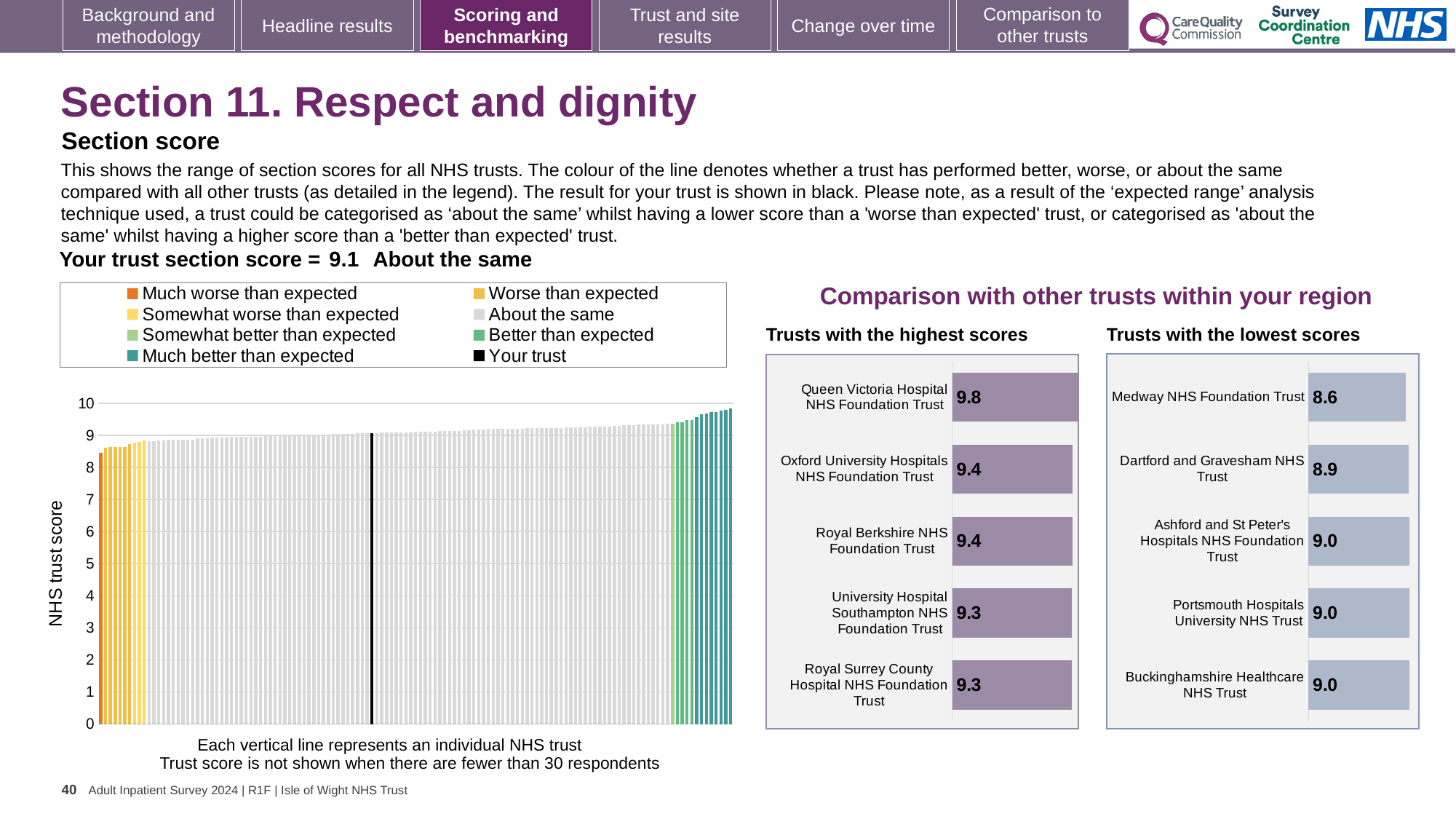
In the 'Trusts with the highest scores' chart, what is the difference between the scores of Queen Victoria Hospital NHS Foundation Trust and Royal Surrey County Hospital NHS Foundation Trust? 0.5 In the 'Trusts with the lowest scores' chart, what is the difference between the scores of Dartford and Gravesham NHS Trust and Medway NHS Foundation Trust? 0.3 In the 'Trusts with the lowest scores' chart, what is the score for Medway NHS Foundation Trust? 8.6 In the 'Trusts with the highest scores' chart, which trust has the highest score? Queen Victoria Hospital NHS Foundation Trust In the 'Trusts with the lowest scores' chart, which trust has the lowest score? Medway NHS Foundation Trust In the 'Trusts with the lowest scores' chart, which has the higher score: Medway NHS Foundation Trust or Dartford and Gravesham NHS Trust? Dartford and Gravesham NHS Trust What kind of chart is the large chart showing NHS trust scores on the left of the slide? Bar chart In the large NHS trust score chart on the left, do the values rise or fall from left to right along the x axis? Rise How many trusts are shown in the 'Trusts with the highest scores' chart? 5 How many entries does the legend of the large NHS trust score chart list? 8 In the 'Trusts with the highest scores' chart, what is the score for University Hospital Southampton NHS Foundation Trust? 9.3 In the 'Trusts with the highest scores' chart, what is the score for Queen Victoria Hospital NHS Foundation Trust? 9.8